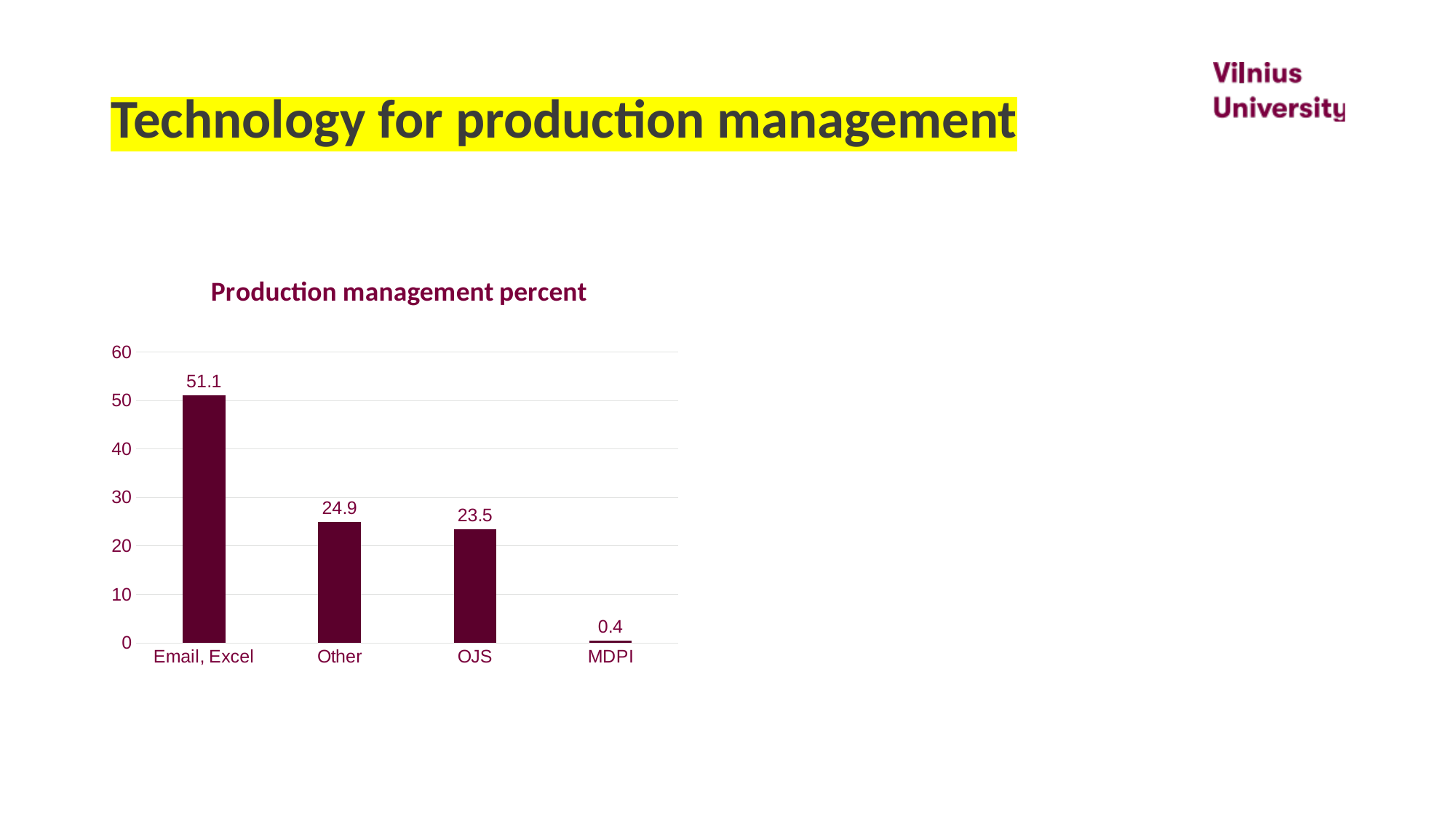
What is the difference between the values for Other and OJS? 1.4 How many categories are shown in the chart? 4 What is the value for MDPI? 0.4 Which is larger, the value for Email, Excel or the value for OJS? Email, Excel Which category has the highest value? Email, Excel What kind of chart is shown on the slide? bar chart What is the value for Email, Excel? 51.1 Is the value for Email, Excel greater or less than 50? greater Which category has the lowest value? MDPI What is the value for Other? 24.9 What is the difference between the values for Email, Excel and Other? 26.2 What is the value for OJS? 23.5